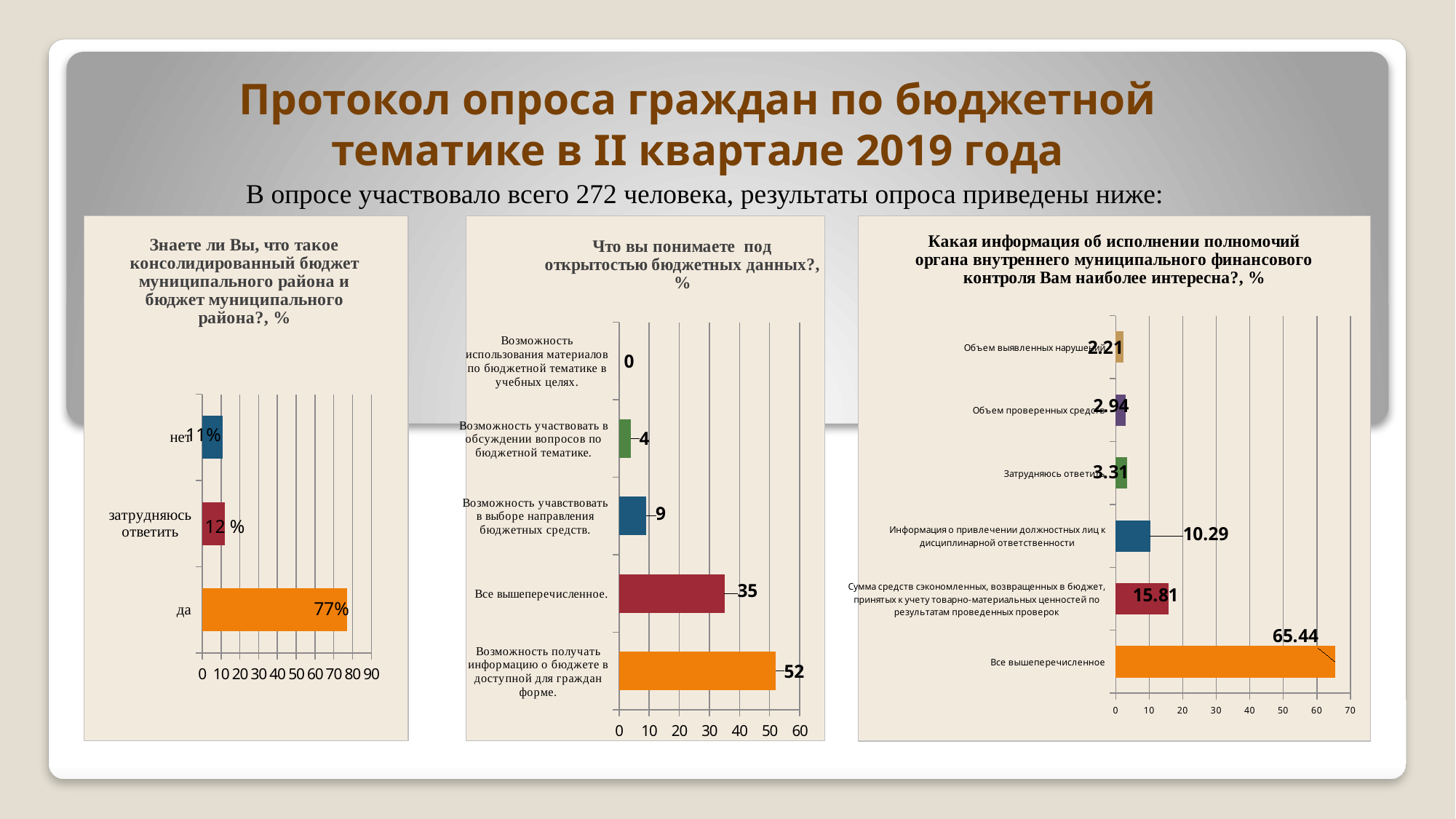
In the left chart, how many categories are shown? 3 In the left chart, which category has the lowest value? нет In the middle chart, what is the value for "Все вышеперечисленное."? 35 In the left chart, what percentage of respondents answered "да"? 77% What type of chart is the right chart? bar chart In the middle chart, which category has the highest value? Возможность получать информацию о бюджете в доступной для граждан форме. In the middle chart, what is the value for "Возможность участвовать в обсуждении вопросов по бюджетной тематике."? 4 In the left chart, what is the value for "затрудняюсь ответить"? 12 % In the middle chart, what is the difference between the values for "Возможность получать информацию о бюджете в доступной для граждан форме." and "Все вышеперечисленное."? 17 In the right chart, what is the value for "Все вышеперечисленное"? 65.44 In the right chart, how many categories are shown? 6 In the right chart, what is the value for "Информация о привлечении должностных лиц к дисциплинарной ответственности"? 10.29